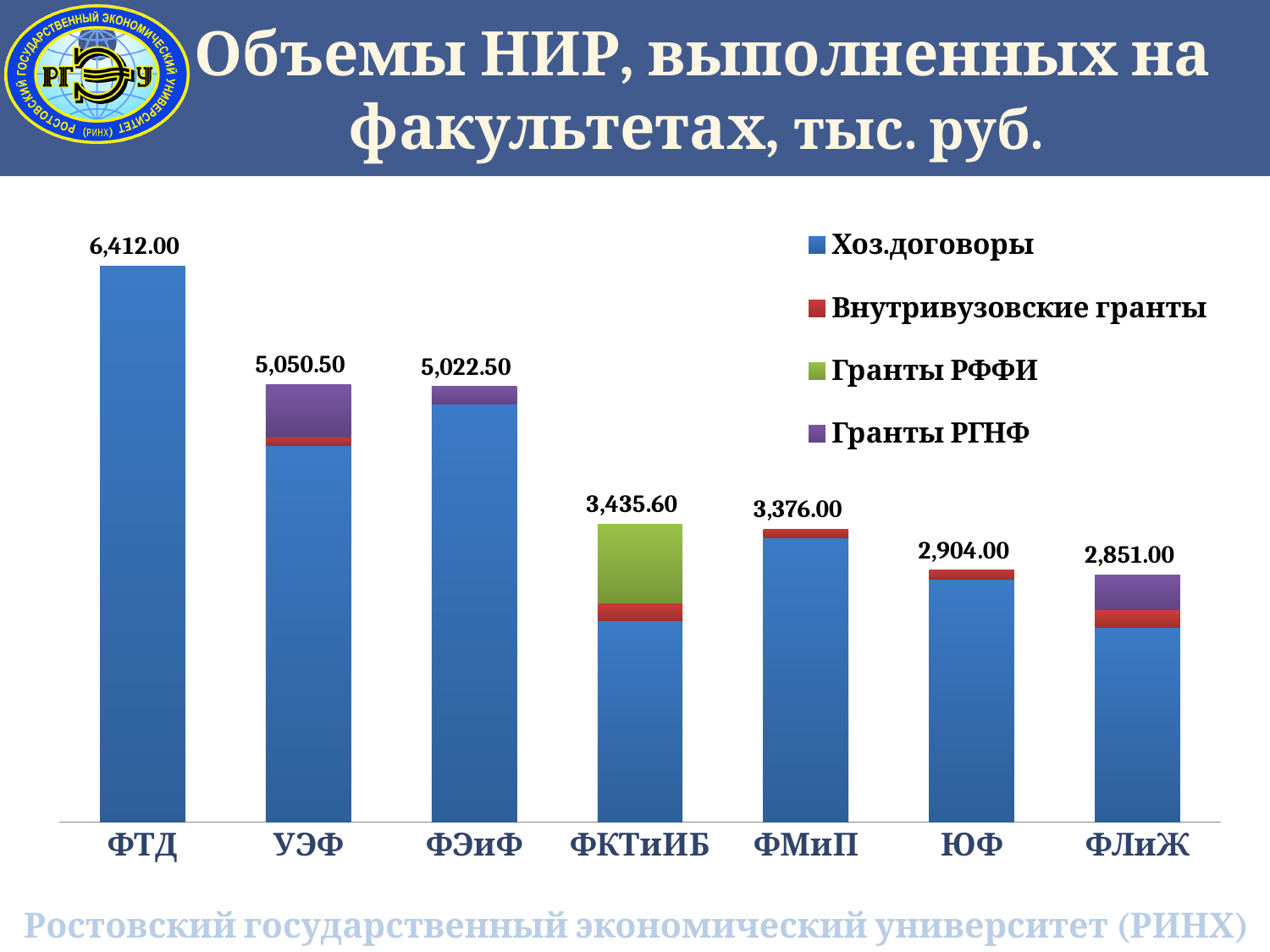
What is the total value shown for ФКТиИБ? 3,435.60 What is the total value shown for ЮФ? 2,904.00 What is the difference between the totals for ФТД and УЭФ? 1,361.50 Do the total values rise or fall from left to right along the x axis? Fall What is the difference between the totals for ФМиП and ЮФ? 472.00 How many series does the legend list? 4 What kind of chart is shown on the slide? Stacked bar chart Which faculty has the highest total value? ФТД Which faculty has the lowest total value? ФЛиЖ What is the total value shown for ФТД? 6,412.00 How many faculties are shown on the x axis? 7 Which has a larger total, УЭФ or ФЭиФ? УЭФ